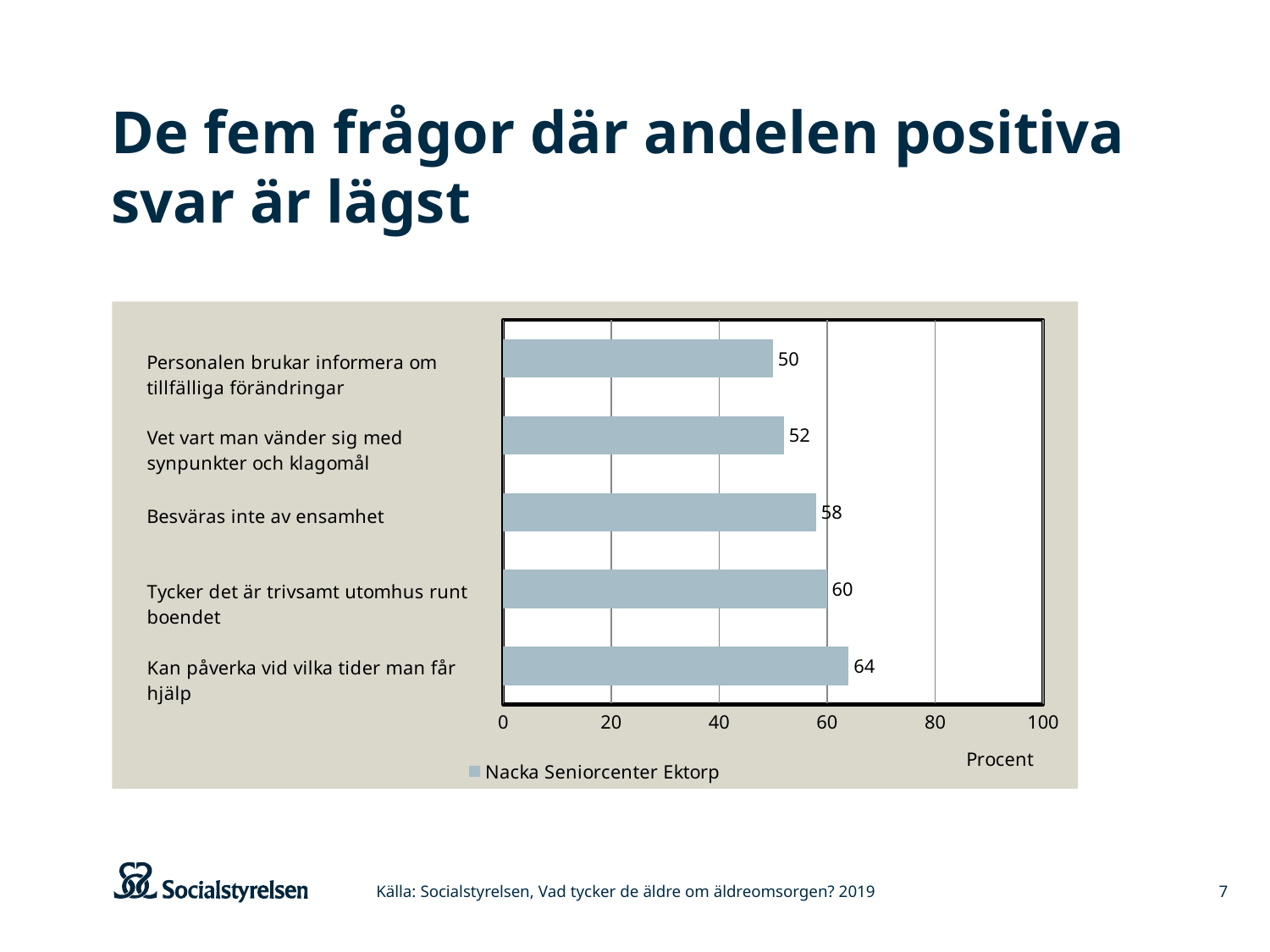
Which category has the lowest value? Personalen brukar informera om tillfälliga förändringar Which category has the highest value? Kan påverka vid vilka tider man får hjälp What kind of chart is shown on the slide? bar chart What is the value for "Kan påverka vid vilka tider man får hjälp"? 64 What is the name of the series shown in the legend? Nacka Seniorcenter Ektorp What is the value for "Besväras inte av ensamhet"? 58 What is the value for "Personalen brukar informera om tillfälliga förändringar"? 50 What is the difference between the values for "Kan påverka vid vilka tider man får hjälp" and "Personalen brukar informera om tillfälliga förändringar"? 14 How many series does the legend list? 1 How many categories are shown in the chart? 5 Is the value for "Tycker det är trivsamt utomhus runt boendet" greater or less than 80? less Which is larger: the value for "Vet vart man vänder sig med synpunkter och klagomål" or the value for "Tycker det är trivsamt utomhus runt boendet"? Tycker det är trivsamt utomhus runt boendet